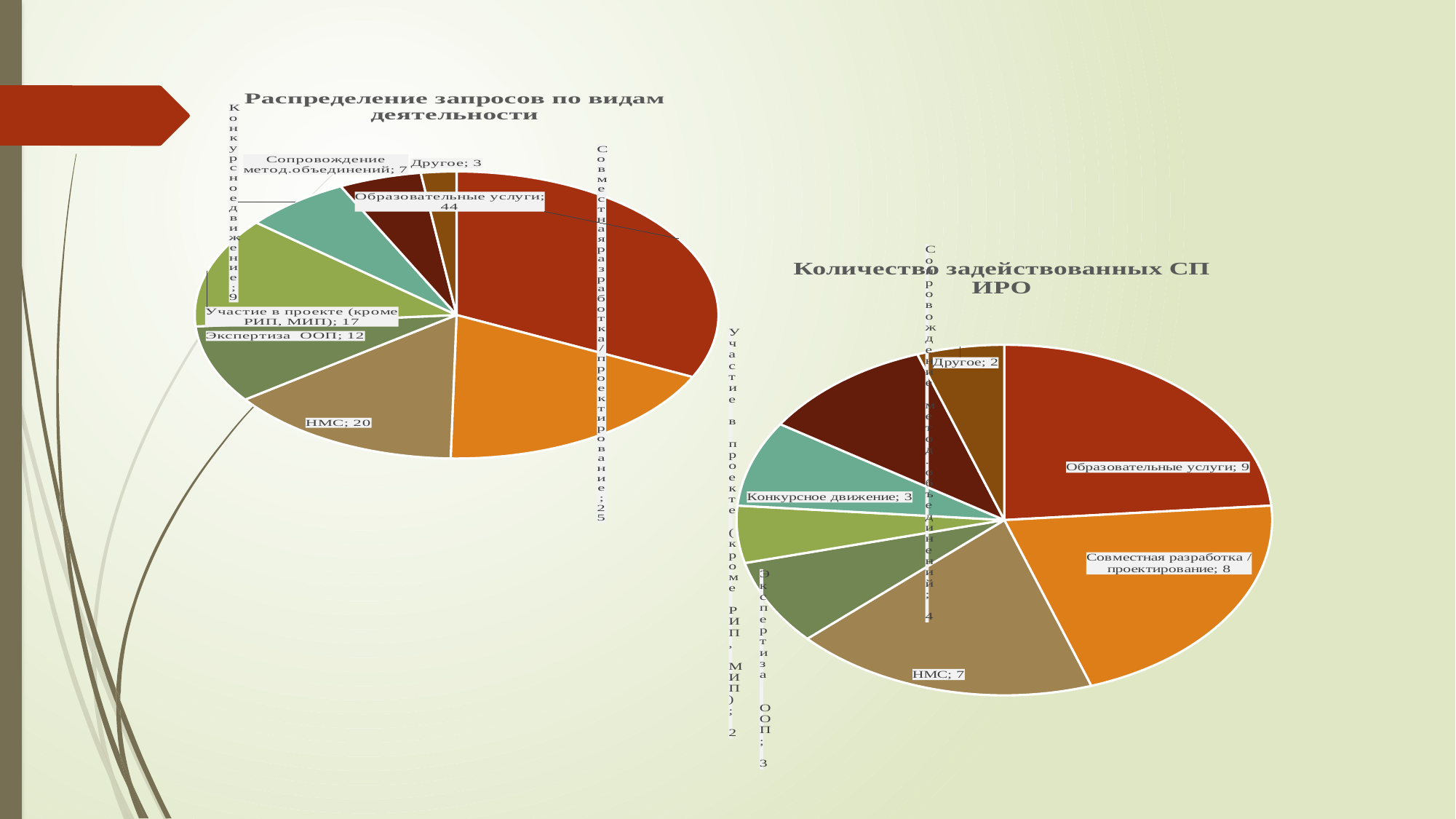
In the chart 'Количество задействованных СП ИРО', what is the value for Совместная разработка / проектирование? 8 In the chart 'Распределение запросов по видам деятельности', how many categories are shown? 8 In the chart 'Количество задействованных СП ИРО', what is the difference between Образовательные услуги and НМС? 2 In the chart 'Распределение запросов по видам деятельности', which category has the largest slice? Образовательные услуги In the chart 'Распределение запросов по видам деятельности', what is the difference between Образовательные услуги and Совместная разработка / проектирование? 19 What type of chart is 'Количество задействованных СП ИРО'? Pie chart In the chart 'Количество задействованных СП ИРО', which category has the largest slice? Образовательные услуги In the chart 'Количество задействованных СП ИРО', what is the value for Сопровождение метод.объединений? 4 In the chart 'Количество задействованных СП ИРО', which is larger: НМС or Конкурсное движение? НМС In the chart 'Распределение запросов по видам деятельности', which category has the smallest slice? Другое In the chart 'Распределение запросов по видам деятельности', what is the value for НМС? 20 In the chart 'Распределение запросов по видам деятельности', what is the value for Образовательные услуги? 44